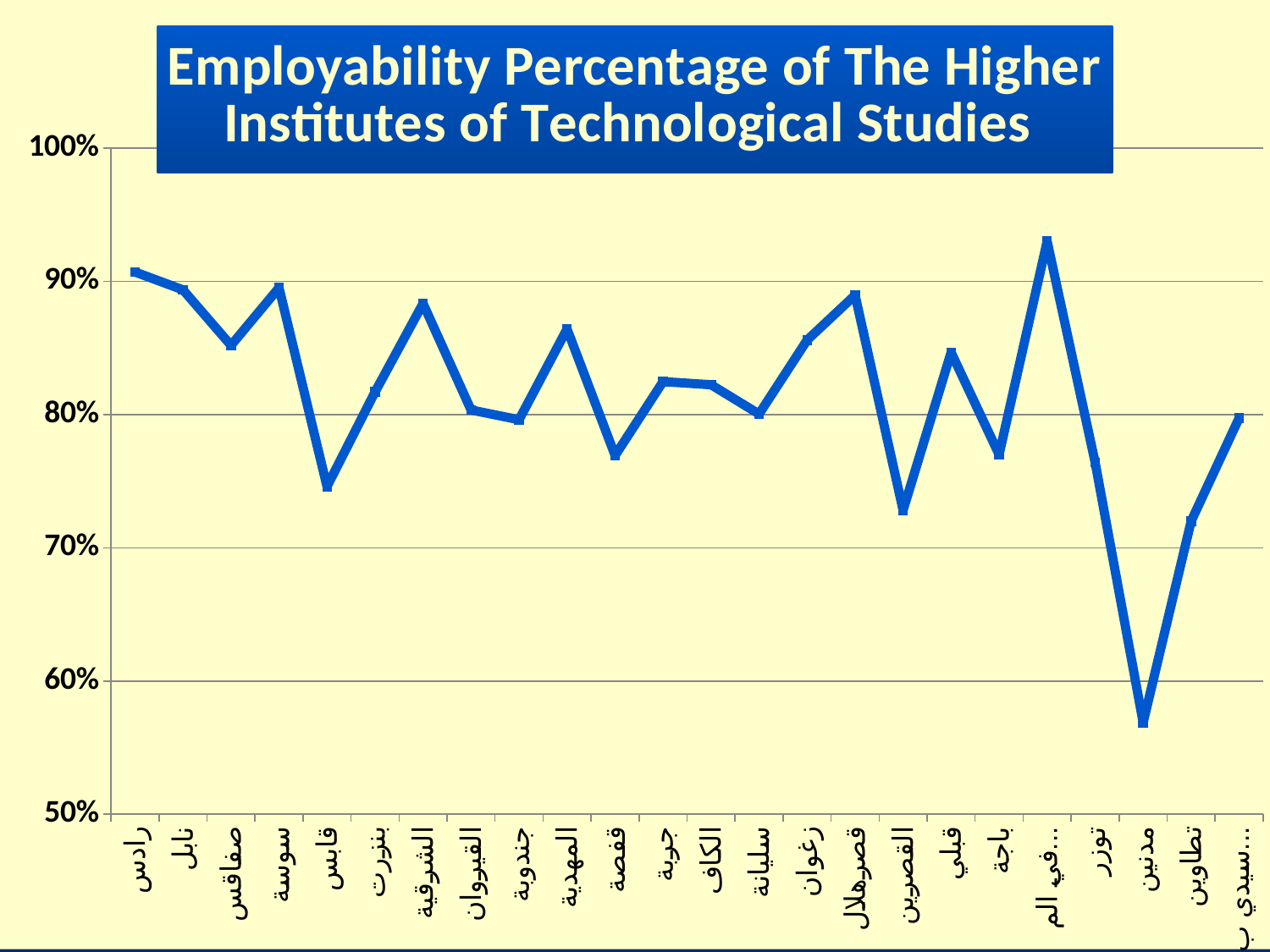
Is the value for مدنين greater or less than 60%? less Which has the higher employability percentage, مدنين or تطاوين? تطاوين How many institutes (categories) are plotted along the x axis? 24 What is the title of the chart? Employability Percentage of The Higher Institutes of Technological Studies Is the value for رادس greater or less than 90%? greater Moving from توزر to مدنين along the x axis, does the line rise or fall? fall Which has the higher employability percentage, رادس or قابس? رادس Is the value for القصرين greater or less than 70%? greater What kind of chart is shown on the slide? line chart Which institute has the lowest employability percentage? مدنين